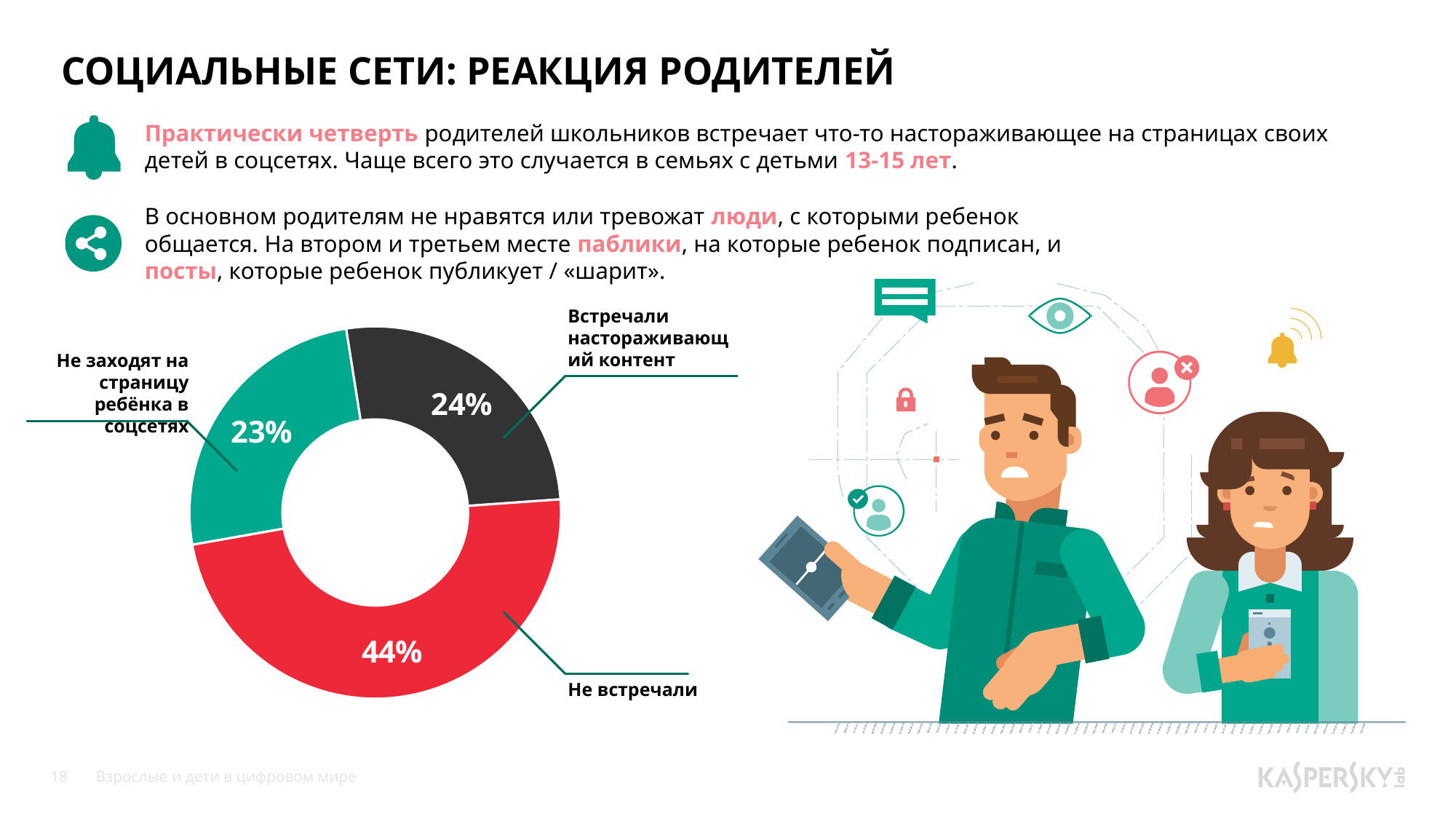
Which category has the largest share of the pie? Не встречали What is the difference in percentage points between "Не встречали" and "Встречали настораживающий контент"? 20 Which category has the smallest share of the pie? Не заходят на страницу ребёнка в соцсетях What is the difference in percentage points between "Встречали настораживающий контент" and "Не заходят на страницу ребёнка в соцсетях"? 1 What percentage of parents did not encounter alarming content ("Не встречали")? 44% Which is larger: the share for "Не встречали" or the share for "Не заходят на страницу ребёнка в соцсетях"? Не встречали What percentage of parents do not visit their child's social network page ("Не заходят на страницу ребёнка в соцсетях")? 23% What percentage of parents encountered alarming content ("Встречали настораживающий контент")? 24% What kind of chart is shown on the slide? Pie chart (donut) What colour is the slice for "Не заходят на страницу ребёнка в соцсетях"? Green How many slices does the pie chart have? 3 What colour is the slice for "Не встречали"? Red